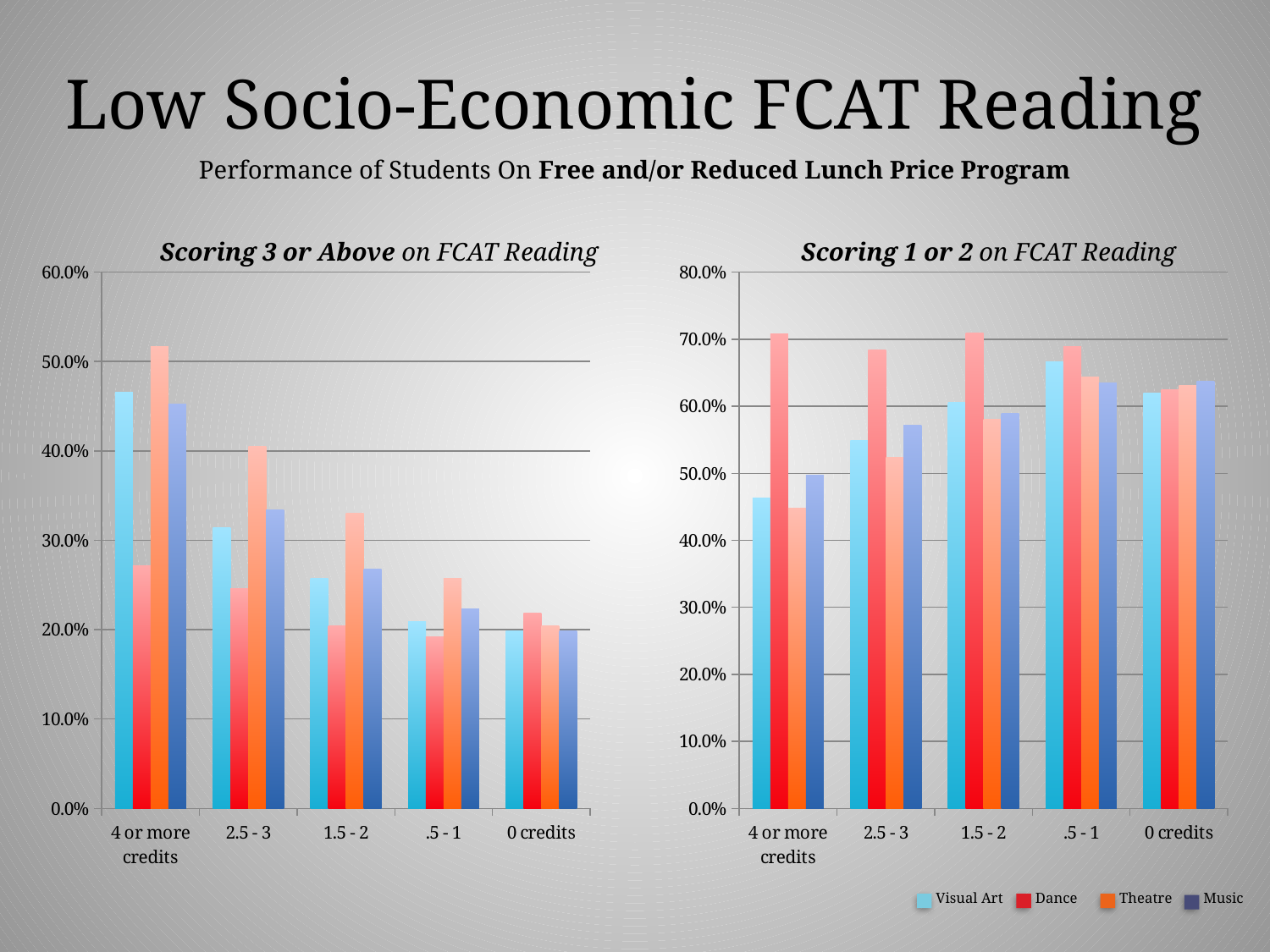
What kind of chart is the 'Scoring 3 or Above on FCAT Reading' chart? Bar chart In the 'Scoring 1 or 2 on FCAT Reading' chart, is the value for Visual Art at '4 or more credits' greater or less than 50.0%? less In the 'Scoring 3 or Above on FCAT Reading' chart, is the value for Dance at '4 or more credits' greater or less than 30.0%? less How many credit categories are shown on the x axis of the 'Scoring 1 or 2 on FCAT Reading' chart? 5 How many series does the legend list for the charts on this slide? 4 In the 'Scoring 3 or Above on FCAT Reading' chart, at '4 or more credits', which is larger: Theatre or Dance? Theatre In the 'Scoring 3 or Above on FCAT Reading' chart, do the Visual Art values rise or fall from '4 or more credits' to '0 credits'? Fall What colour represents the Dance series in the legend? Red In the 'Scoring 1 or 2 on FCAT Reading' chart, at '4 or more credits', which is larger: Dance or Visual Art? Dance In the 'Scoring 1 or 2 on FCAT Reading' chart, is the value for Dance at '4 or more credits' greater or less than 70.0%? greater In the 'Scoring 3 or Above on FCAT Reading' chart, which series has the highest bar overall? Theatre (4 or more credits)